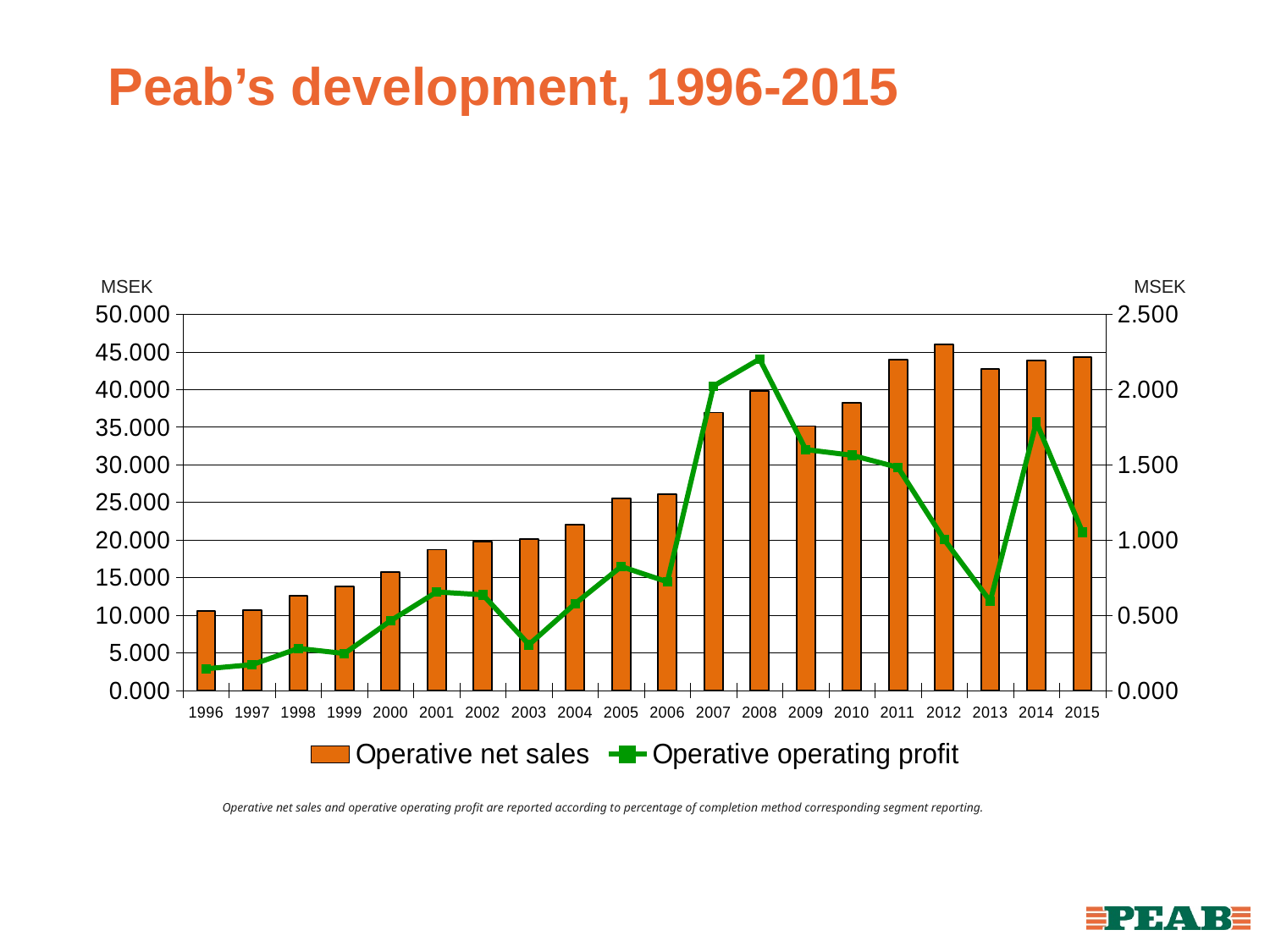
What type of chart is shown on the slide? A combined bar and line chart Is operative operating profit for 2013 greater or less than 1.000 MSEK? less Is operative net sales for 2007 greater or less than 35.000 MSEK? greater How many years are shown on the x axis? 20 Which year has higher operative net sales, 2008 or 2009? 2008 In which year is operative operating profit highest? 2008 Is operative operating profit for 2014 greater or less than 1.500 MSEK? greater How many series does the legend list? 2 Which year has higher operative operating profit, 2011 or 2012? 2011 In which year is operative net sales highest? 2012 Overall, does operative net sales rise or fall from 1996 to 2015? Rise